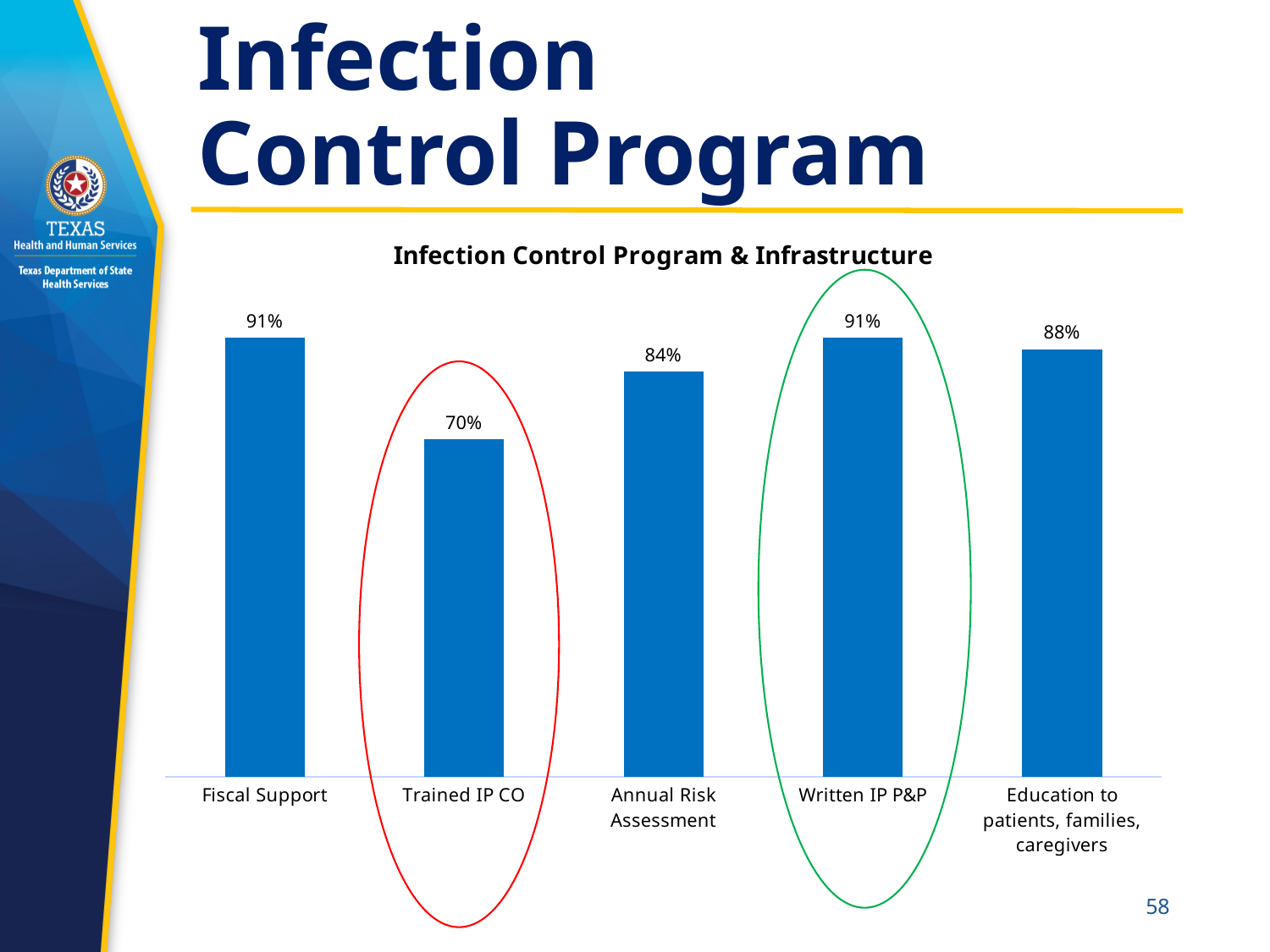
What is the value for Education to patients, families, caregivers? 88% What is the title of the chart? Infection Control Program & Infrastructure Which category's bar is circled in red? Trained IP CO How many categories are shown in the chart? 5 What is the difference between the values for Education to patients, families, caregivers and Annual Risk Assessment? 4% What is the value for Annual Risk Assessment? 84% Which category has the lowest value? Trained IP CO What kind of chart is shown on the slide? Bar chart Which is larger, the value for Annual Risk Assessment or the value for Education to patients, families, caregivers? Education to patients, families, caregivers What is the value for Written IP P&P? 91% What is the difference between the values for Fiscal Support and Trained IP CO? 21% What is the value for Trained IP CO? 70%